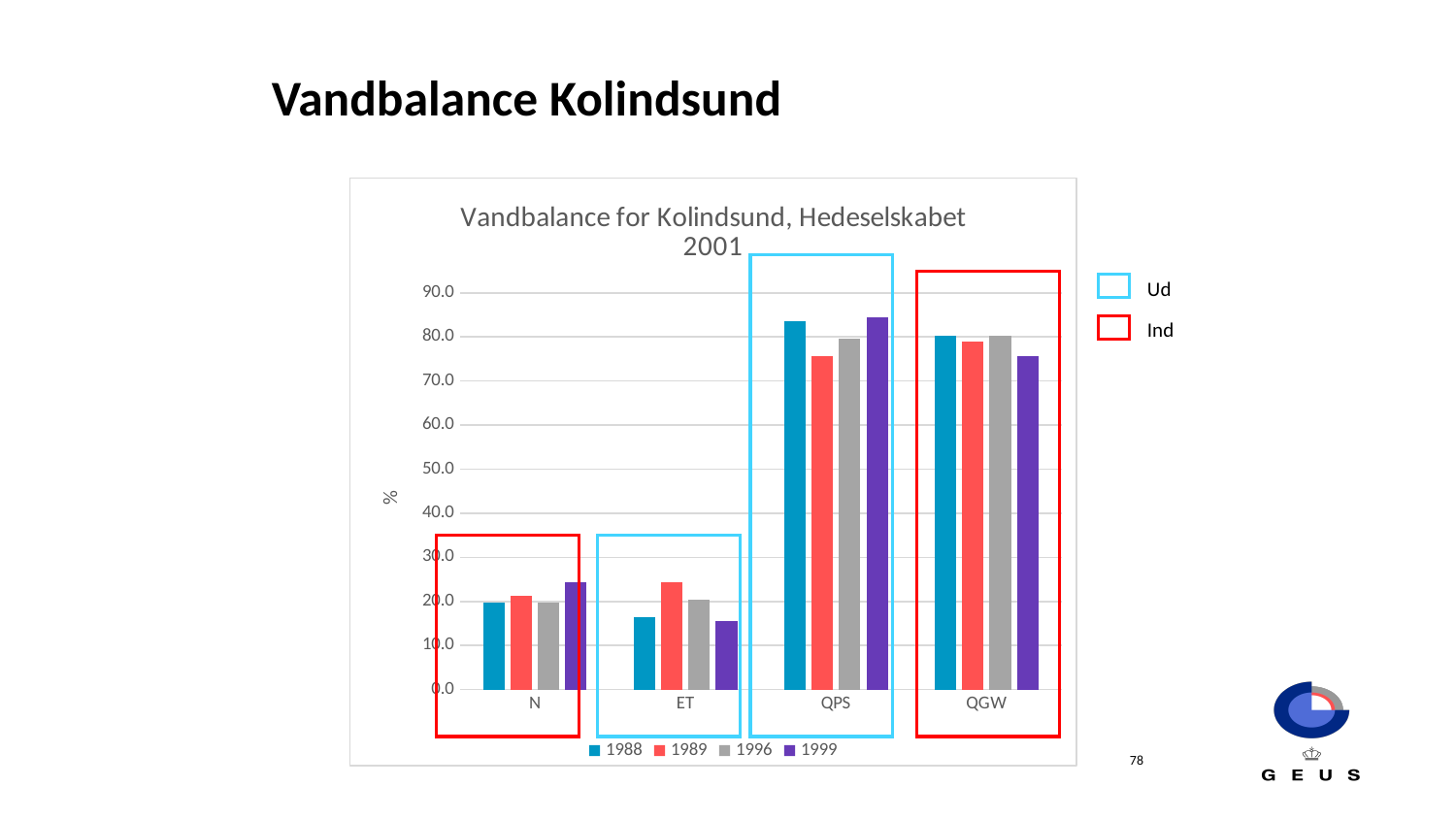
How many categories are shown on the x axis of the chart? 4 What is the title of the chart? Vandbalance for Kolindsund, Hedeselskabet 2001 What kind of chart is shown on the slide? bar chart How many series does the chart legend list? 4 Which is larger: the 1989 value for ET or the 1999 value for ET? 1989 value for ET Is the value for QGW in 1999 greater or less than 80.0? less Is the value for ET in 1988 greater or less than 20.0? less What is the label on the y axis of the chart? % Is the value for QPS in 1988 greater or less than 80.0? greater Within the QPS category, which year has the lowest value? 1989 Within the ET category, which year has the highest value? 1989